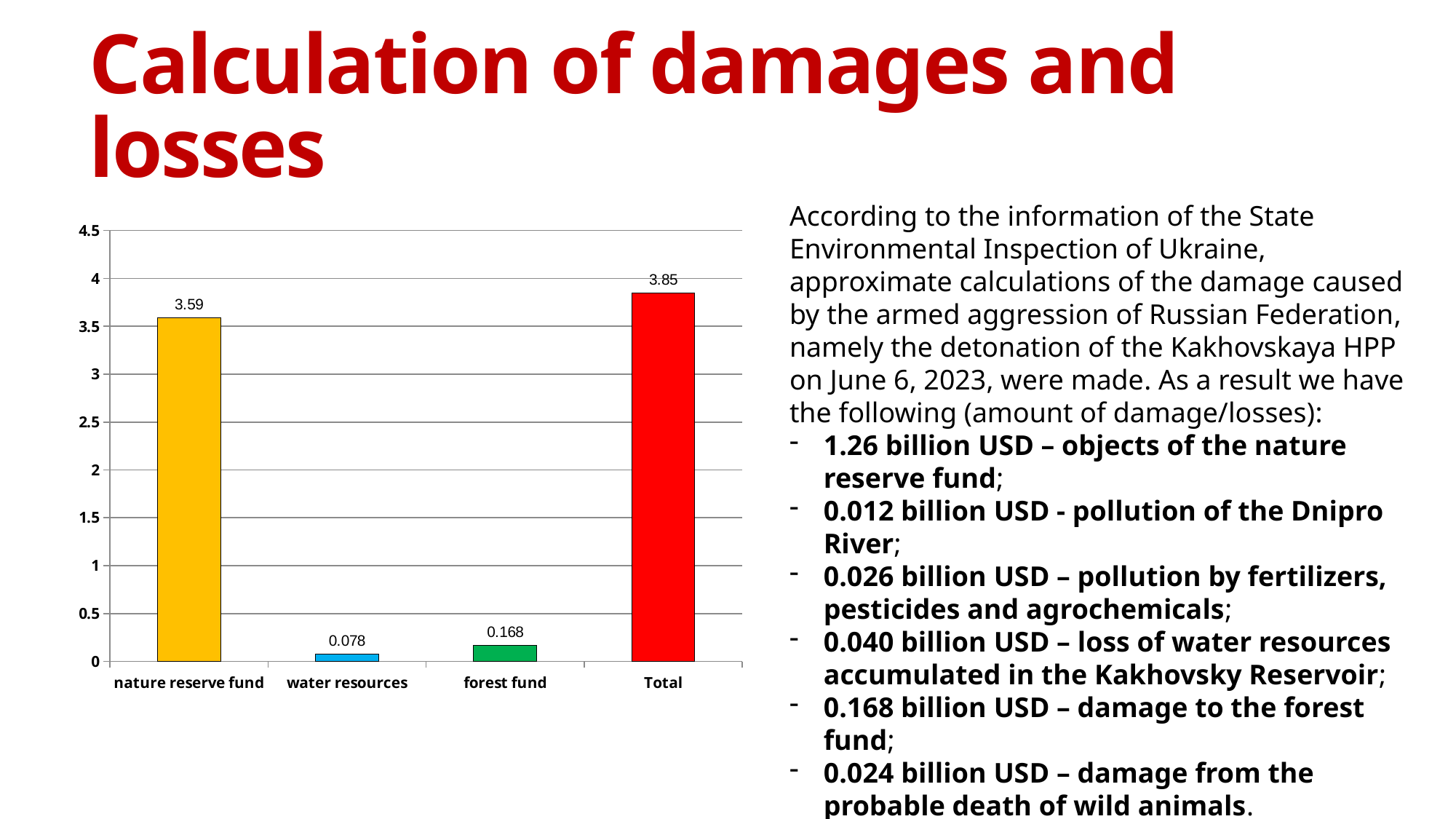
Which category has the highest value? Total Is the value for nature reserve fund greater or less than 3.5? greater What is the difference between the Total and the nature reserve fund values? 0.26 What kind of chart is shown on the slide? bar chart What is the value for Total? 3.85 What is the value for nature reserve fund? 3.59 How many categories are shown on the x axis? 4 What is the difference between the forest fund and water resources values? 0.09 Which is larger, the value for forest fund or the value for water resources? forest fund What is the value for forest fund? 0.168 Which category has the lowest value? water resources What is the value for water resources? 0.078